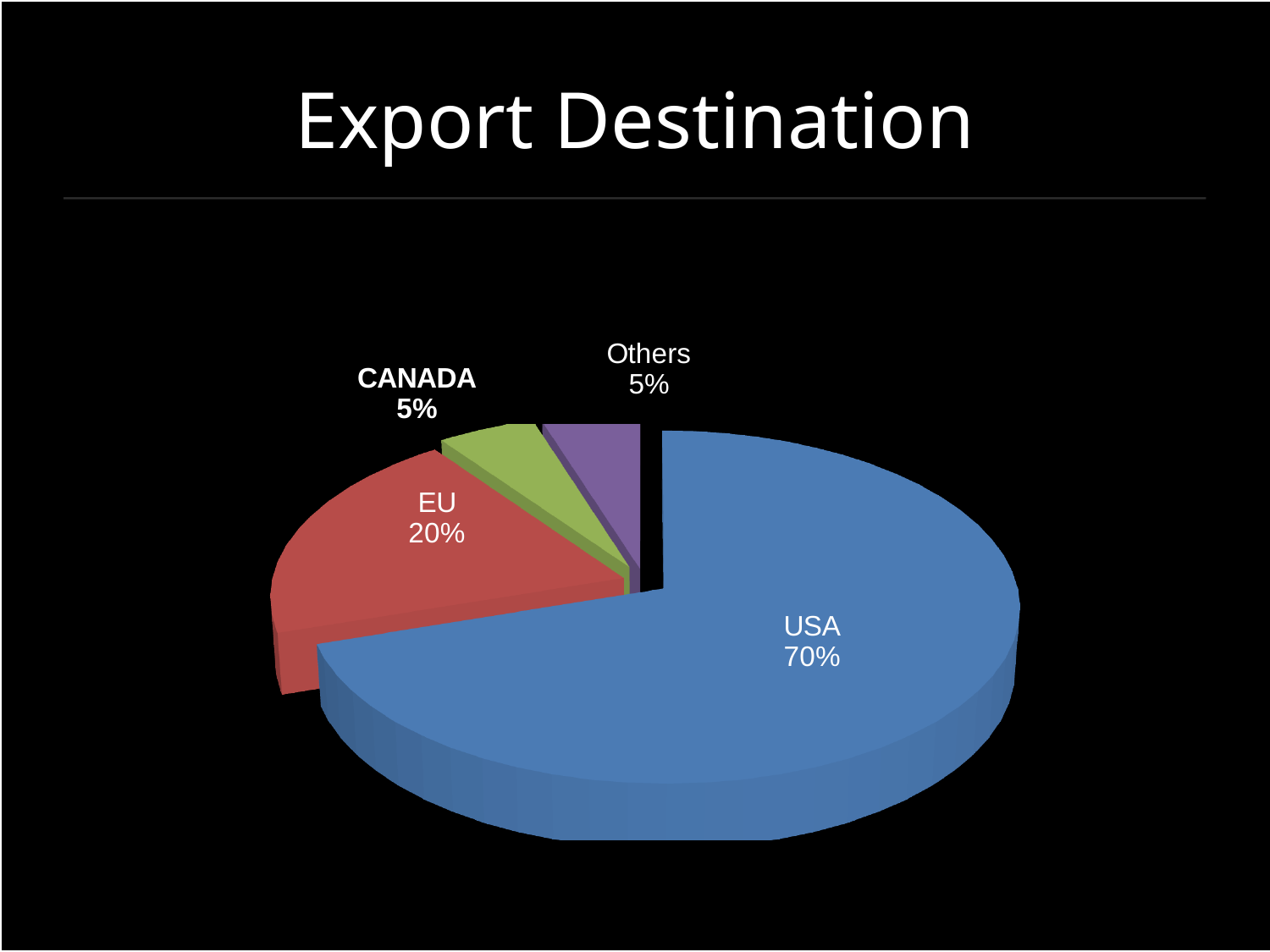
How many export destinations are shown in the pie chart? 4 What share of exports goes to Canada? 5% What colour is the USA slice? Blue Which export destination has the largest share? USA What kind of chart is shown on the slide? Pie chart What share of exports goes to the USA? 70% What share of exports goes to the EU? 20% What is the difference in share between the USA and the EU? 50 percentage points Which has a larger share, the EU or Canada? EU What is the difference in share between the EU and Canada? 15 percentage points What is the title of the slide? Export Destination What share of exports goes to Others? 5%